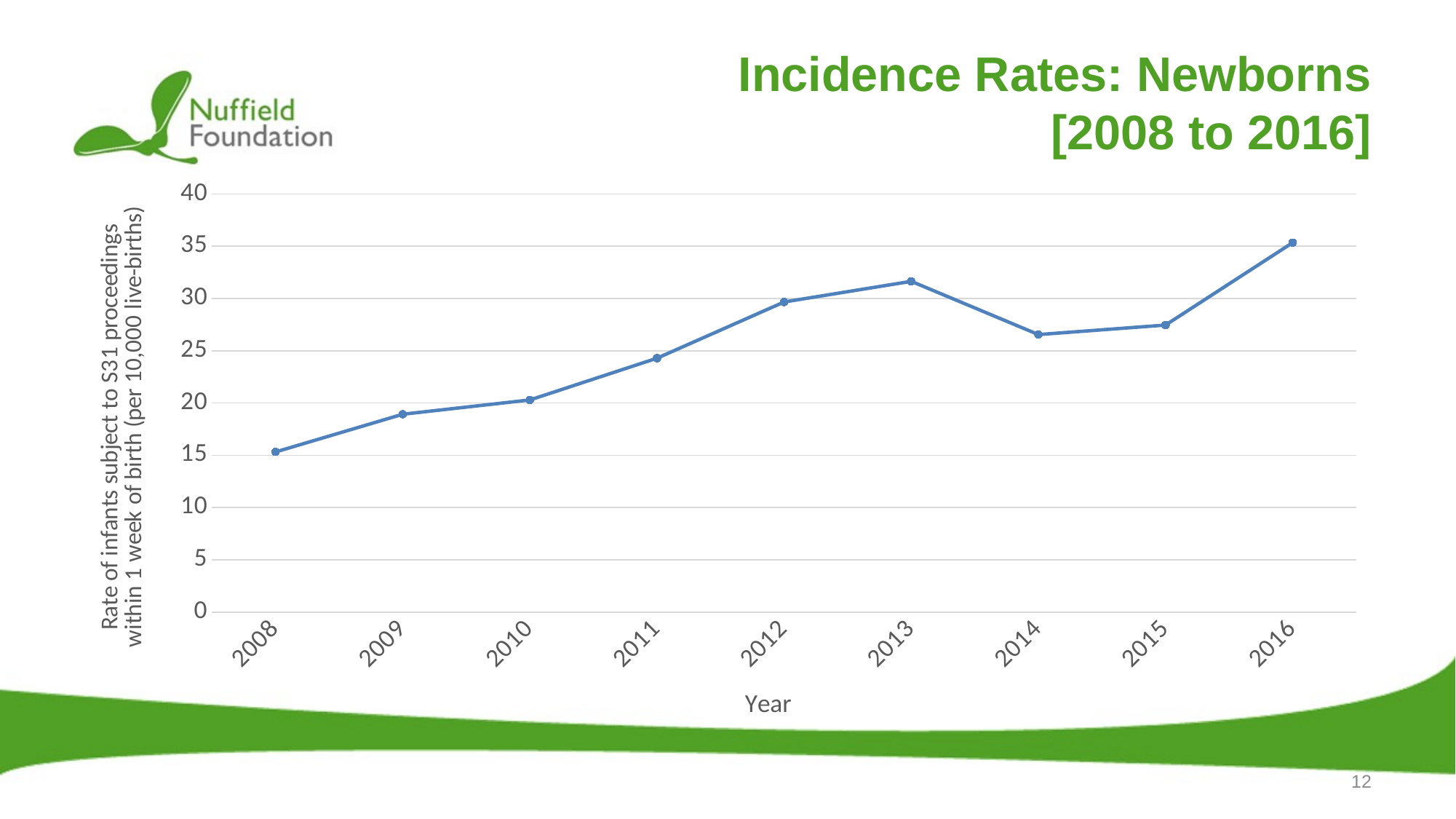
What kind of chart is shown on the slide? Line chart Which year has the lowest rate of infants subject to S31 proceedings? 2008 Is the value for 2016 greater or less than 30? greater Overall, does the rate rise or fall from 2008 to 2016? Rise Which year has the higher rate, 2013 or 2014? 2013 Which year has the highest rate of infants subject to S31 proceedings? 2016 How many years are plotted on the x axis? 9 Is the value for 2014 greater or less than 30? less Is the value for 2008 greater or less than 20? less Which year has the higher rate, 2012 or 2015? 2012 What is the label of the x axis? Year